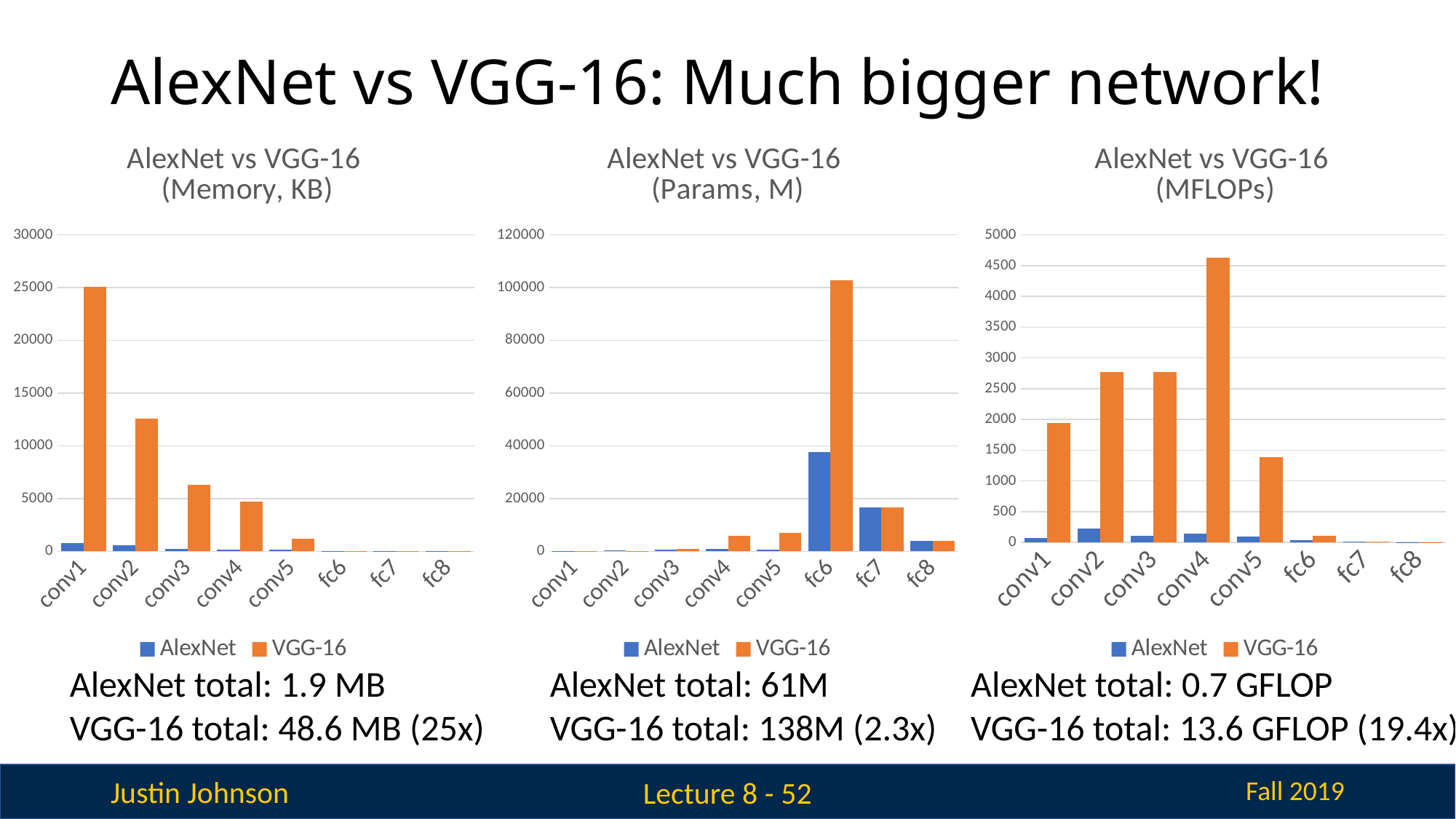
In the AlexNet vs VGG-16 (Params, M) chart, is the VGG-16 value for fc6 greater or less than 100000? greater In the AlexNet vs VGG-16 (Params, M) chart, which layer has the highest VGG-16 value? fc6 In the AlexNet vs VGG-16 (Memory, KB) chart, is the VGG-16 value for conv1 greater or less than 20000? greater How many series does the legend of the AlexNet vs VGG-16 (Params, M) chart list? 2 How many layers are shown on the x axis of the AlexNet vs VGG-16 (MFLOPs) chart? 8 In the AlexNet vs VGG-16 (MFLOPs) chart, which layer has the highest VGG-16 value? conv4 In the AlexNet vs VGG-16 (Memory, KB) chart, which layer has the highest VGG-16 value? conv1 In the AlexNet vs VGG-16 (Memory, KB) chart, do the VGG-16 values rise or fall from conv1 to fc8? fall In the AlexNet vs VGG-16 (MFLOPs) chart, is the VGG-16 value for conv5 greater or less than 1500? less In the AlexNet vs VGG-16 (Memory, KB) chart, which is larger for VGG-16: conv2 or conv3? conv2 What kind of chart is the AlexNet vs VGG-16 (Memory, KB) chart? bar chart